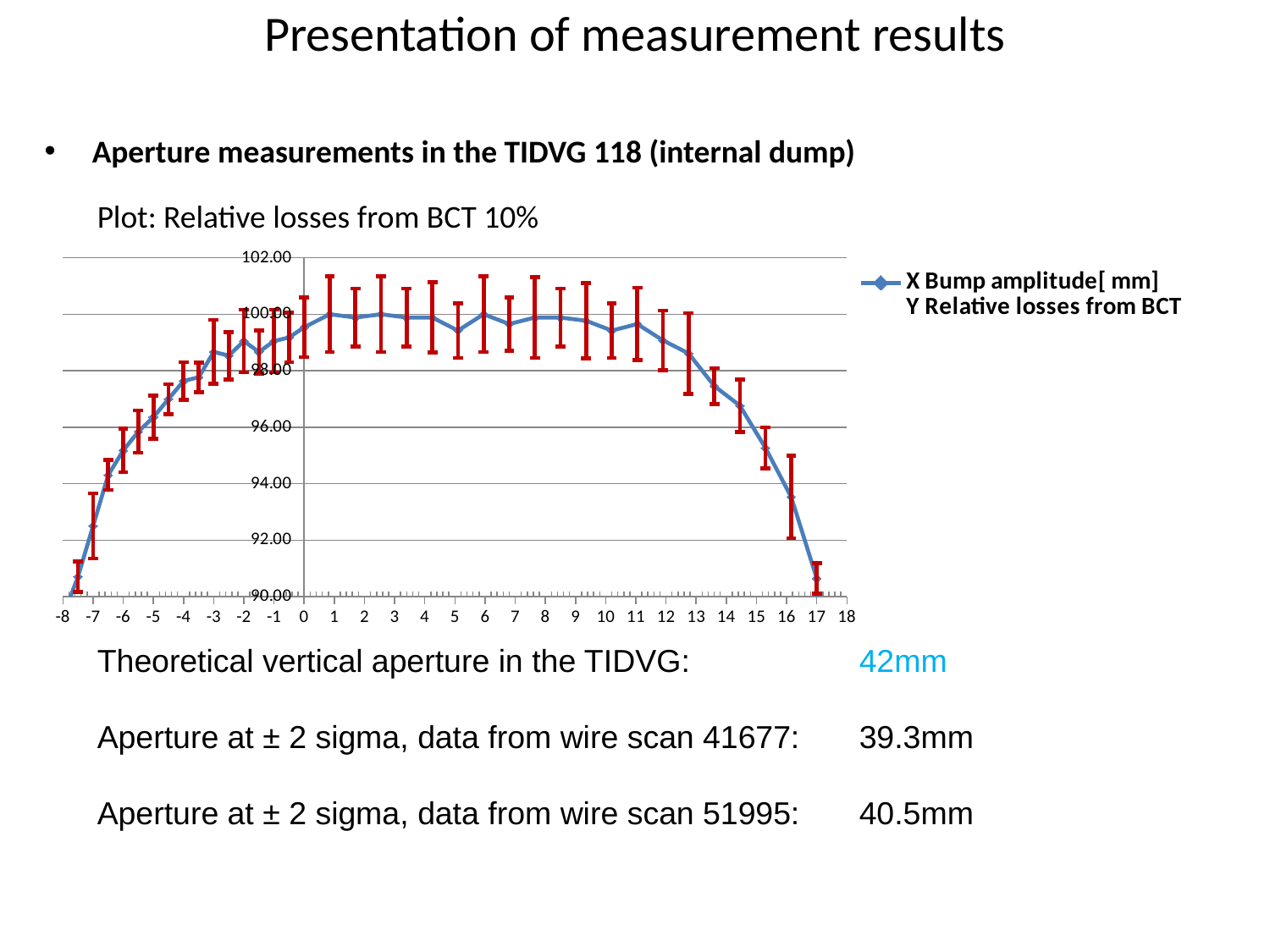
Is the value at x = 16 greater or less than 92? greater What is the highest value shown on the chart's y axis? 102.00 Is the value at x = -6 greater or less than 94? greater Is the value at x = 17 greater or less than 92? less How many series does the chart legend list? 1 Which has the larger value, x = -6 or x = 14? x = 14 Do the plotted values rise or fall as x goes from 11 to 17? fall Do the plotted values rise or fall as x goes from -7 to 0? rise What kind of chart is shown on the slide? line chart What is the legend entry for the plotted series? X Bump amplitude[ mm] Y Relative losses from BCT